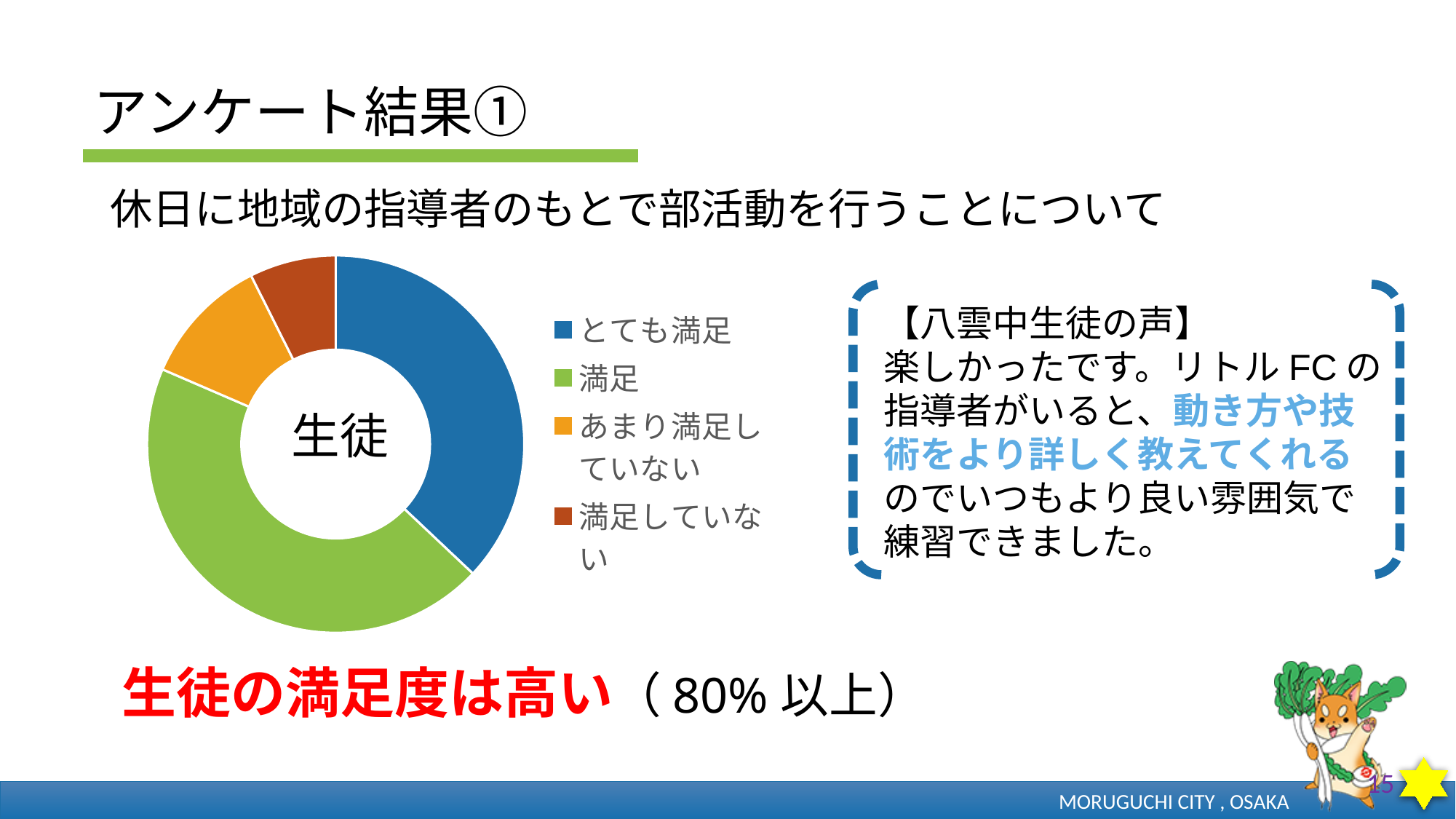
Which is larger in the chart, the share for とても満足 or the share for あまり満足していない? とても満足 Which is larger in the chart, the share for 満足 or the share for あまり満足していない? 満足 What kind of chart is shown on the slide? Doughnut chart Which is larger in the chart, the share for 満足 or the share for 満足していない? 満足 Which colour represents 満足 in the chart? Green How many categories does the chart's legend list? 4 What text is written in the centre of the doughnut chart? 生徒